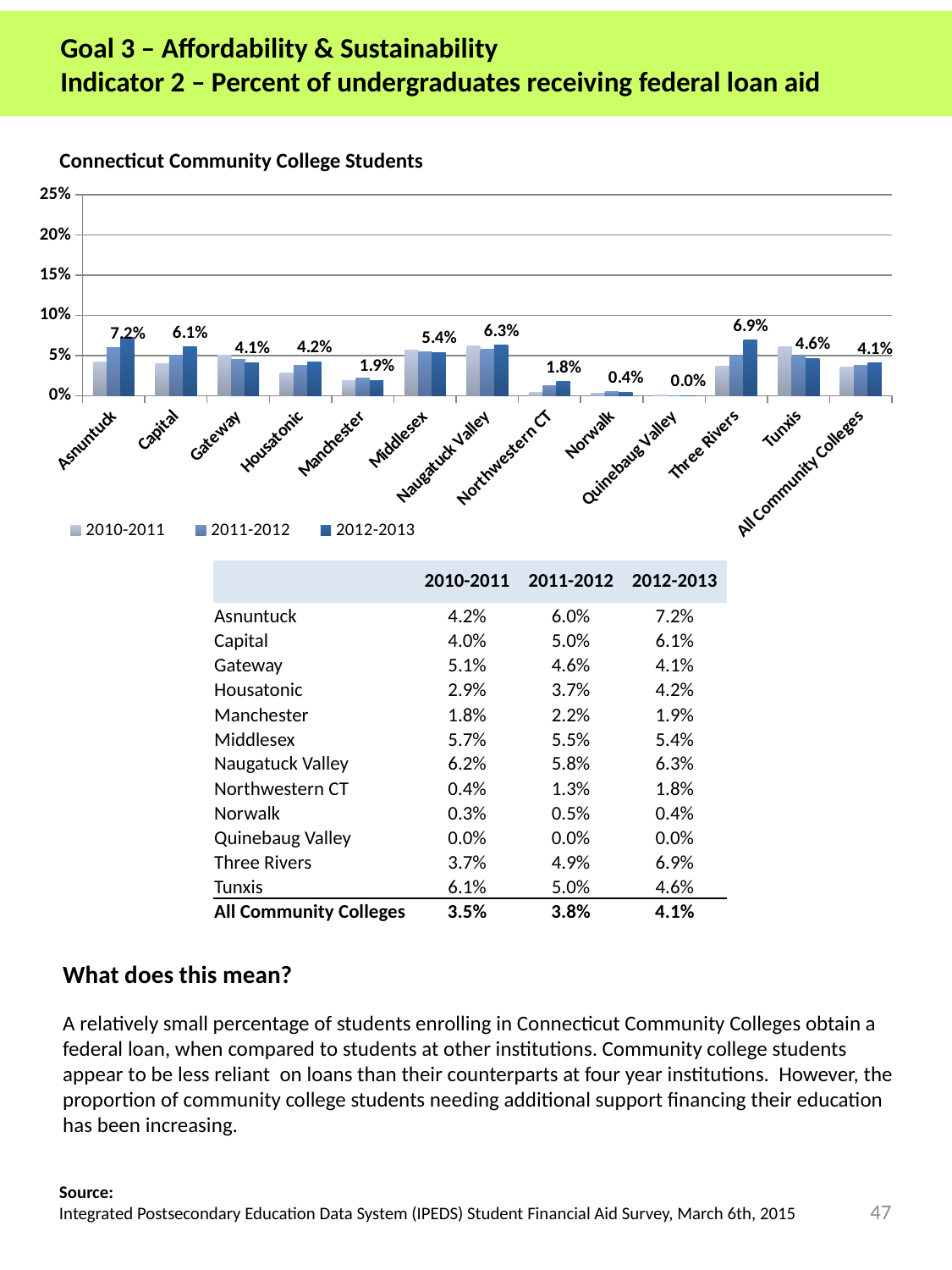
What is the 2012-2013 value for Asnuntuck? 7.2% What kind of chart is shown on the slide? bar chart Which category has the highest 2012-2013 value? Asnuntuck What is the title of the chart? Connecticut Community College Students Do the values for All Community Colleges rise or fall from 2010-2011 to 2012-2013? rise What is the 2012-2013 value for Northwestern CT? 1.8% How many series does the chart legend list? 3 Which category has the lowest 2012-2013 value? Quinebaug Valley How many categories are shown along the x axis of the chart? 13 Which has the larger 2012-2013 value, Capital or Naugatuck Valley? Naugatuck Valley Is the 2012-2013 value for Tunxis greater or less than 5%? less What is the difference between the 2012-2013 values for Asnuntuck and Three Rivers? 0.3%